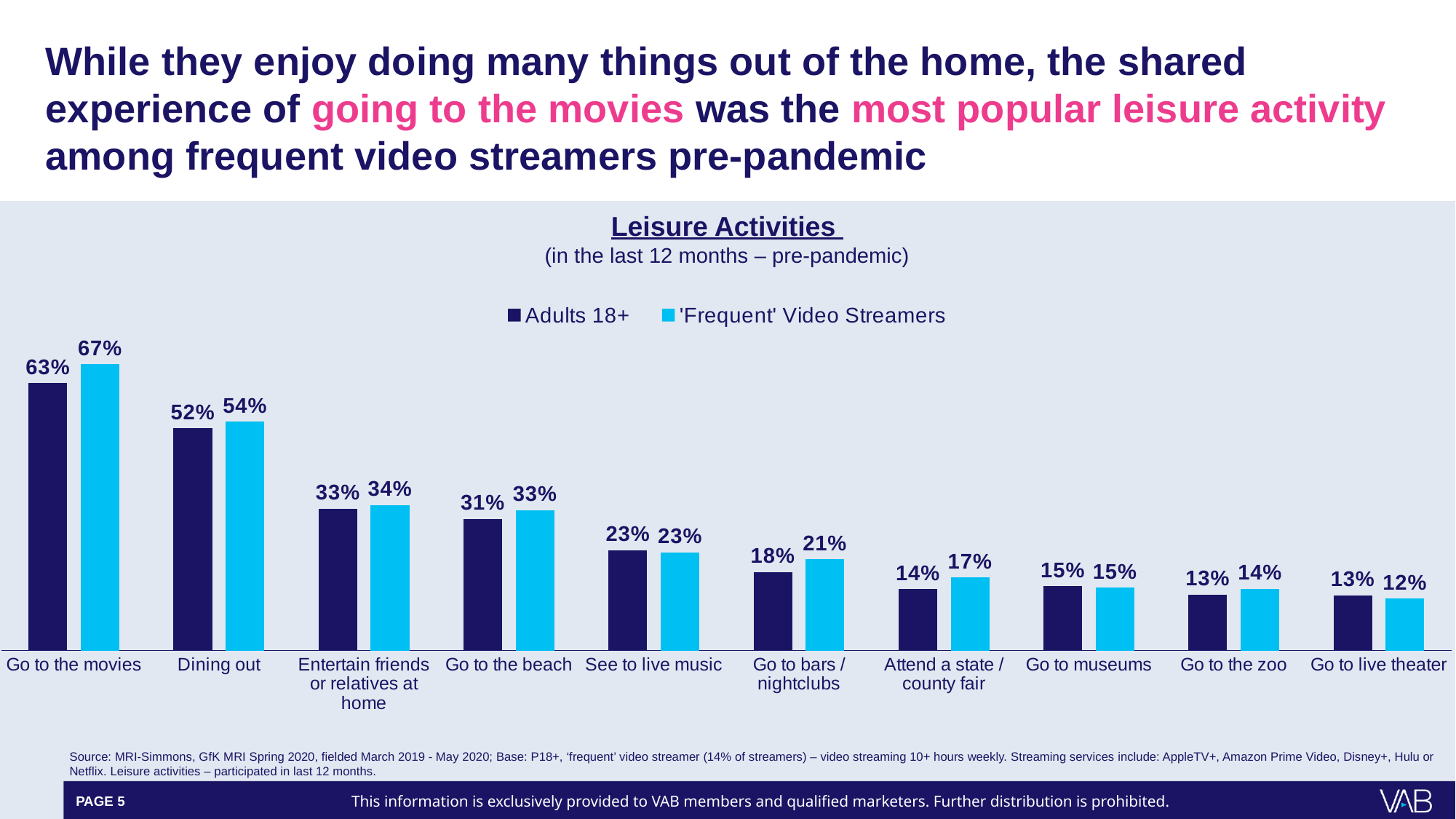
Which is larger for Attend a state / county fair: Adults 18+ or 'Frequent' Video Streamers? 'Frequent' Video Streamers Which leisure activity has the lowest value for 'Frequent' Video Streamers? Go to live theater What is the difference between 'Frequent' Video Streamers and Adults 18+ for Go to the movies? 4% Which leisure activity has the highest value for Adults 18+? Go to the movies What percentage of 'Frequent' Video Streamers went to the movies? 67% What kind of chart is shown on the slide? Bar chart What is the title of the chart? Leisure Activities Do the Adults 18+ values generally rise or fall from left to right across the activities? Fall How many leisure activities are shown on the chart? 10 How many series does the legend list? 2 What is the value for Adults 18+ for Dining out? 52% What percentage of 'Frequent' Video Streamers went to bars / nightclubs? 21%